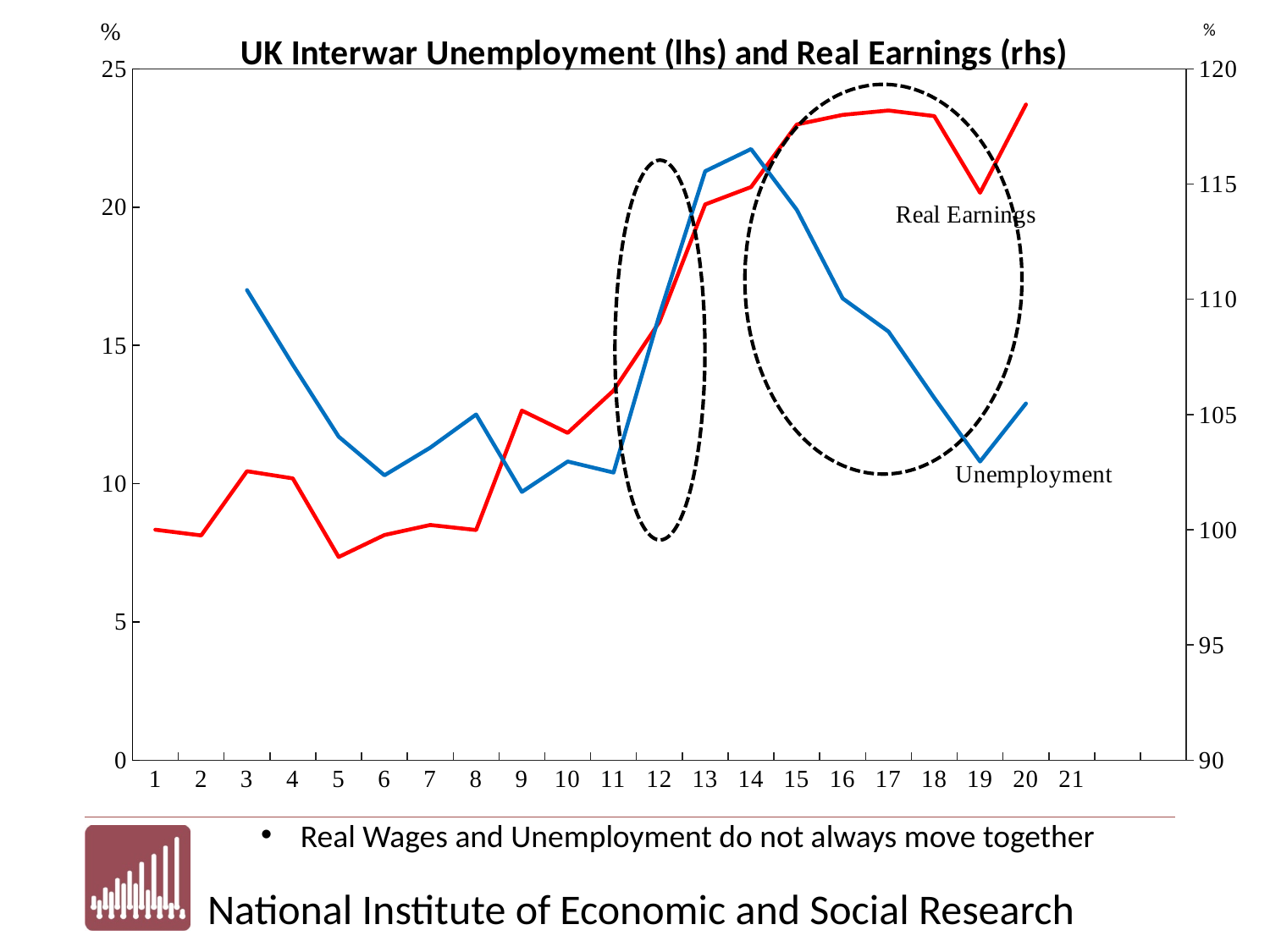
At which x-axis point does Real Earnings reach its lowest value? 5 Which series is drawn in blue? Unemployment Is the Real Earnings value at point 5 greater or less than 100? less Is the Unemployment value at point 14 greater or less than 20? greater How many labelled points are there on the x axis? 21 Is the Real Earnings value at point 17 greater or less than 115? greater At which x-axis point does Unemployment reach its highest value? 14 What is the title of the chart? UK Interwar Unemployment (lhs) and Real Earnings (rhs) Does Unemployment rise or fall between points 14 and 19? fall How many series are plotted on the chart? 2 What kind of chart is shown on the slide? line chart Which is larger for Real Earnings: the value at point 17 or the value at point 5? point 17